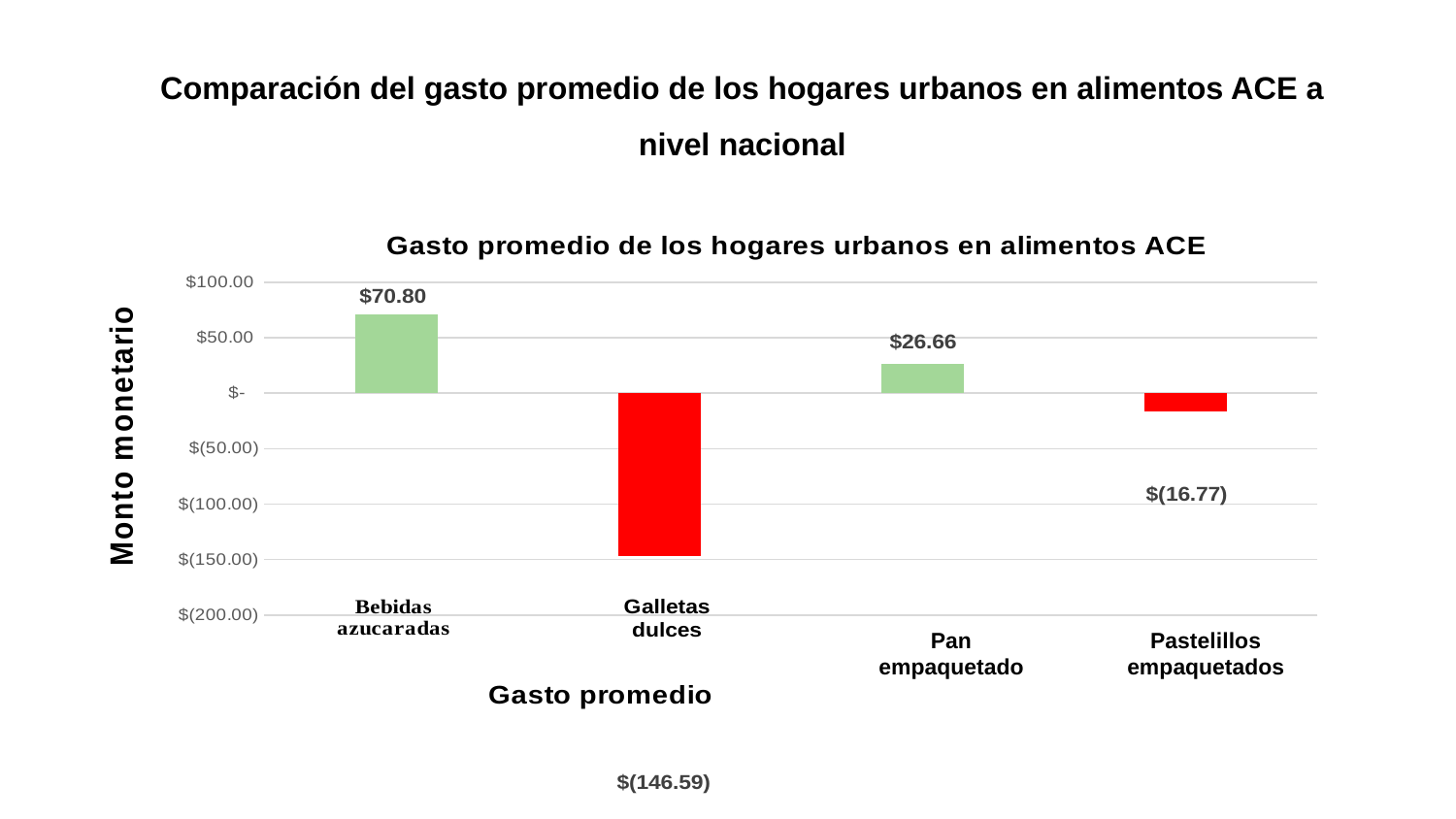
Which is larger, the value for Pan empaquetado or the value for Pastelillos empaquetados? Pan empaquetado Is the value for Galletas dulces greater or less than $(100.00)? less How many categories are shown on the x axis? 4 What is the value for Pastelillos empaquetados? $(16.77) Which category has the highest value? Bebidas azucaradas What is the value for Pan empaquetado? $26.66 What is the difference between the values for Bebidas azucaradas and Pan empaquetado? $44.14 What is the value for Bebidas azucaradas? $70.80 What is the value for Galletas dulces? $(146.59) What is the title of the chart? Gasto promedio de los hogares urbanos en alimentos ACE Which category has the lowest value? Galletas dulces What kind of chart is shown on the slide? bar chart